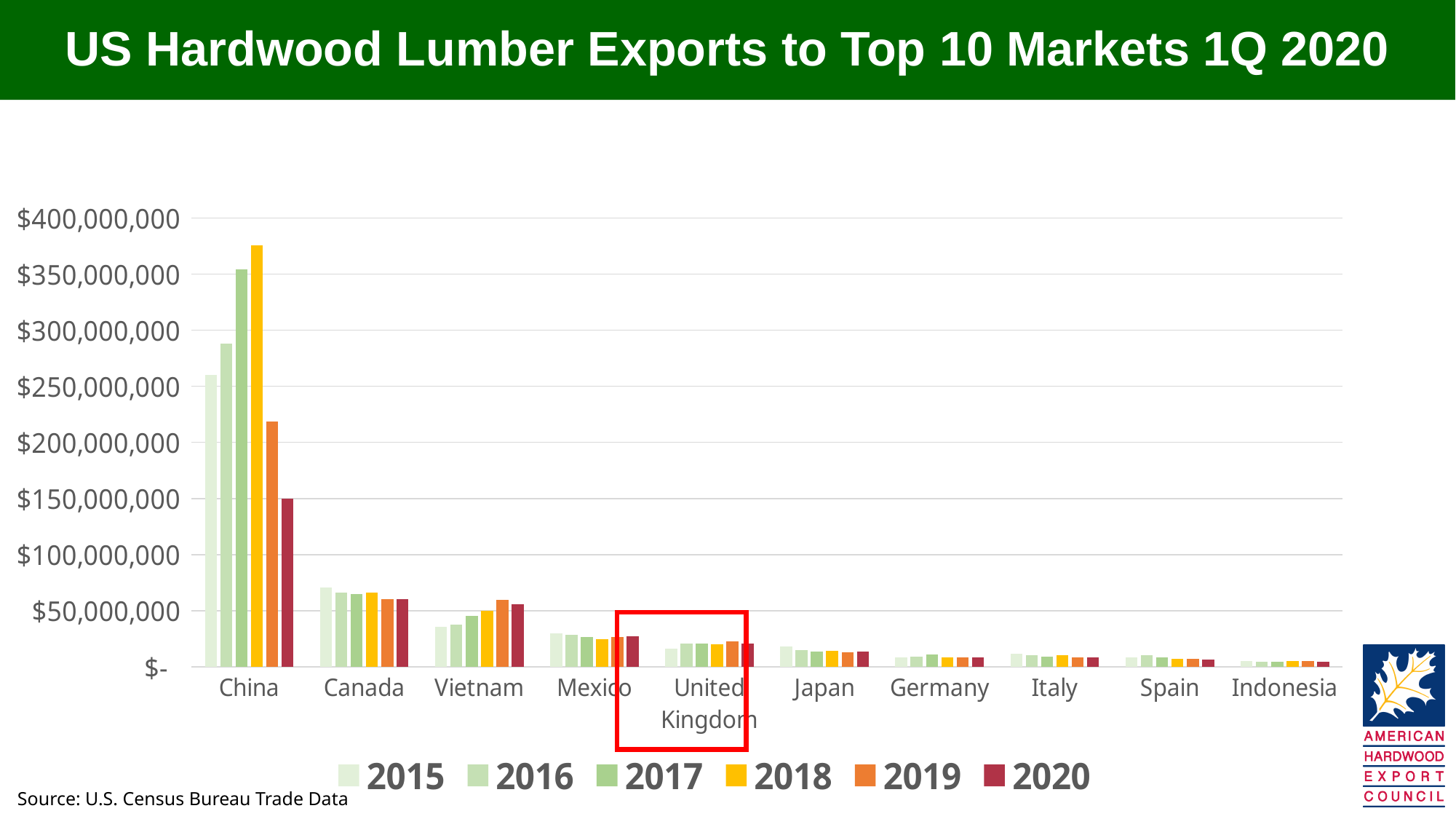
Do China's values rise or fall from 2018 to 2020? fall Is the 2015 value for Canada greater or less than $50,000,000? greater How many markets are shown along the x axis? 10 What kind of chart is shown on the slide? bar chart Is the 2018 value for China greater or less than $350,000,000? greater Which market is highlighted with a red box on the chart? United Kingdom Is the 2020 value for China greater or less than $200,000,000? less For China, which is larger: the 2018 value or the 2019 value? 2018 For Vietnam, which is larger: the 2015 value or the 2019 value? 2019 How many series does the legend list? 6 Which market has the lowest 2020 value? Indonesia Which market has the highest 2020 value? China